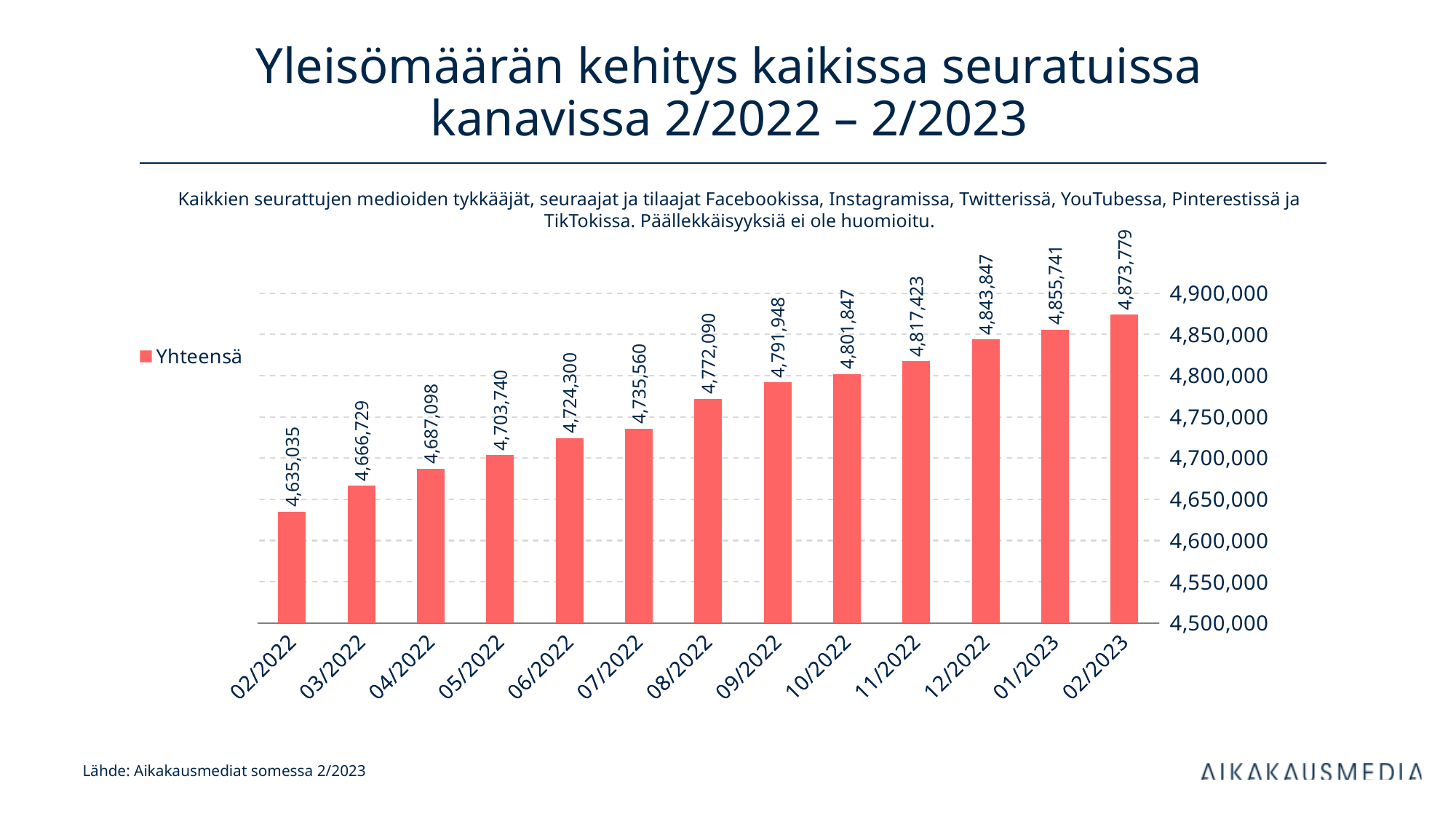
How many months are shown on the x axis? 13 What kind of chart is shown on the slide? Bar chart What is the value for 02/2023? 4,873,779 What is the value for 08/2022? 4,772,090 Is the value for 09/2022 greater or less than 4,750,000? greater Which month has the highest value? 02/2023 What is the difference between the values for 03/2022 and 02/2022? 31,694 Which is larger, the value for 06/2022 or the value for 10/2022? 10/2022 What is the value for 02/2022? 4,635,035 Which month has the lowest value? 02/2022 Do the values rise or fall from 02/2022 to 02/2023? Rise What is the difference between the values for 02/2023 and 02/2022? 238,744